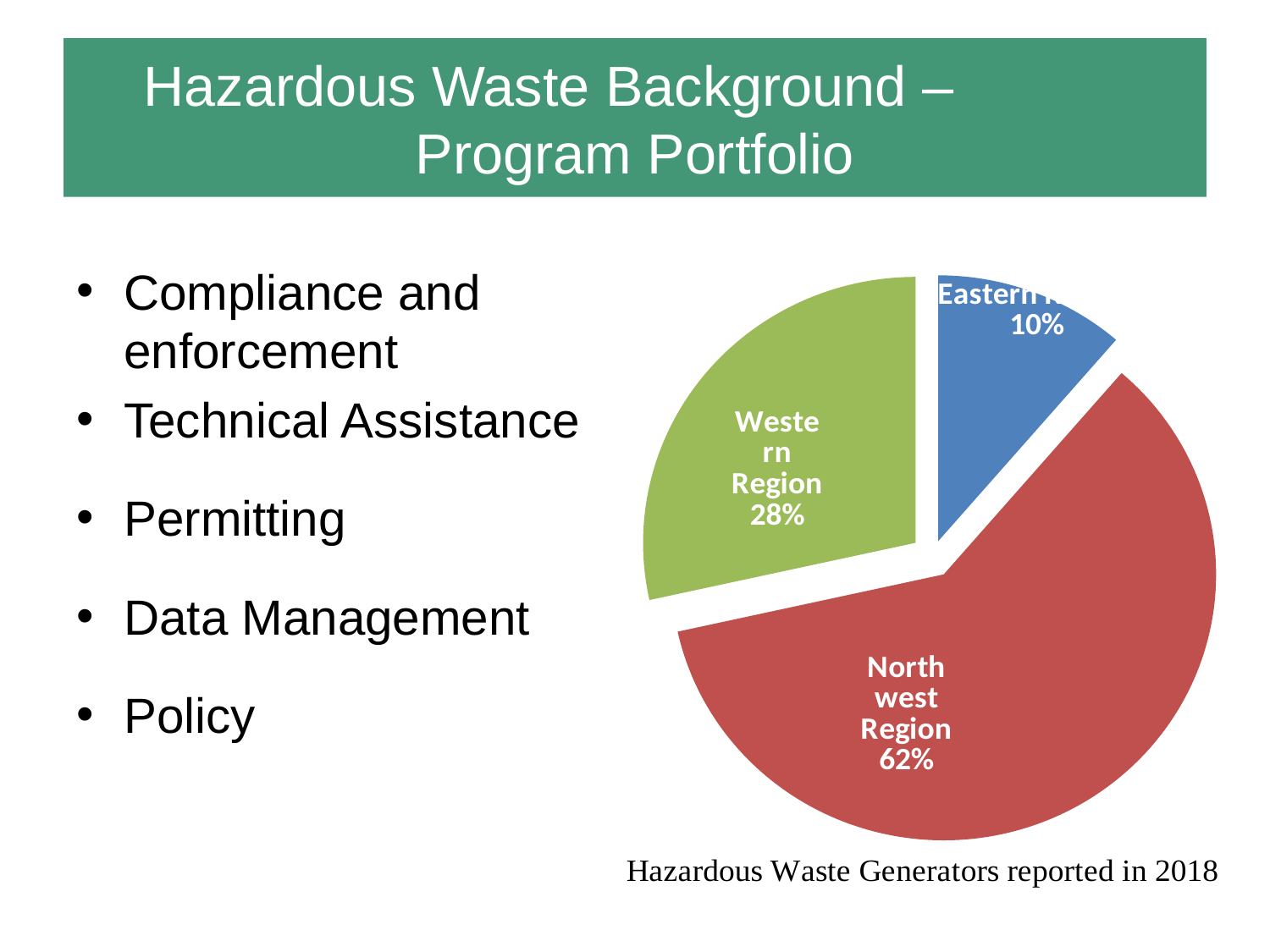
What does the caption below the pie chart say the data represents? Hazardous Waste Generators reported in 2018 What share of the pie does the Western Region slice represent? 28% Which region has the smallest slice of the pie? Eastern Which slice is larger, Western Region or Eastern? Western Region What kind of chart is shown on the slide? pie chart What is the difference in percentage points between the Western Region and the Eastern slices? 18 What share of the pie does the Eastern slice represent? 10% What is the difference in percentage points between the Northwest Region and the Western Region slices? 34 How many slices does the pie chart have? 3 What share of the pie does the Northwest Region slice represent? 62% Which region has the largest slice of the pie? Northwest Region What colour is the Northwest Region slice? red